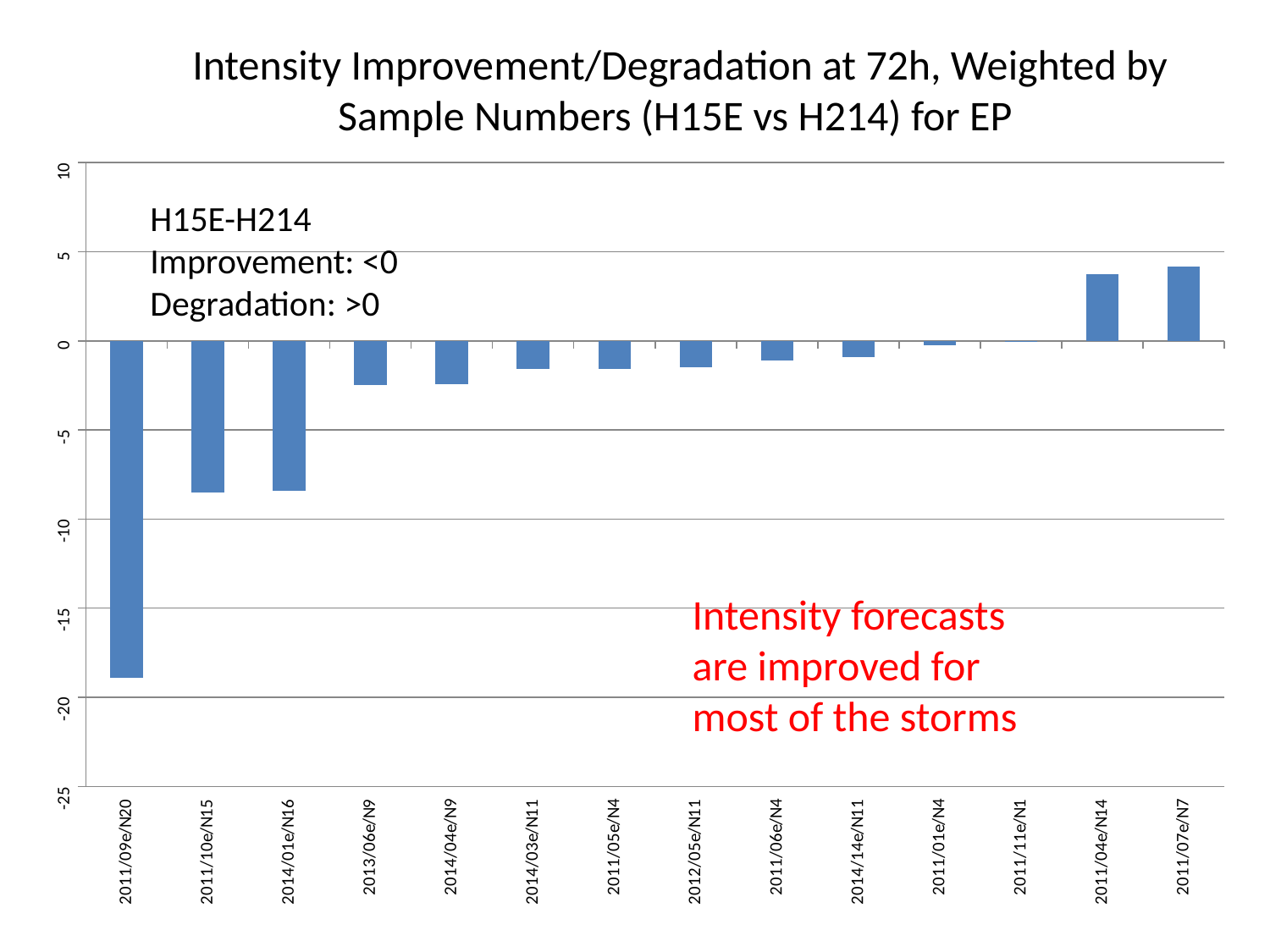
Do the bar values generally rise or fall moving left to right along the x axis? rise What kind of chart is shown on the slide? bar chart According to the text on the chart, does a value below 0 indicate improvement or degradation? Improvement Which storm has the lowest (most negative) value? 2011/09e/N20 Is the value for 2013/06e/N9 greater or less than -5? greater Which has the lower value, 2011/09e/N20 or 2011/10e/N15? 2011/09e/N20 Is the value for 2011/04e/N14 greater or less than 0? greater How many storm categories are plotted along the x axis? 14 Is the value for 2011/09e/N20 greater or less than -15? less How many storms have a positive (degradation) value? 2